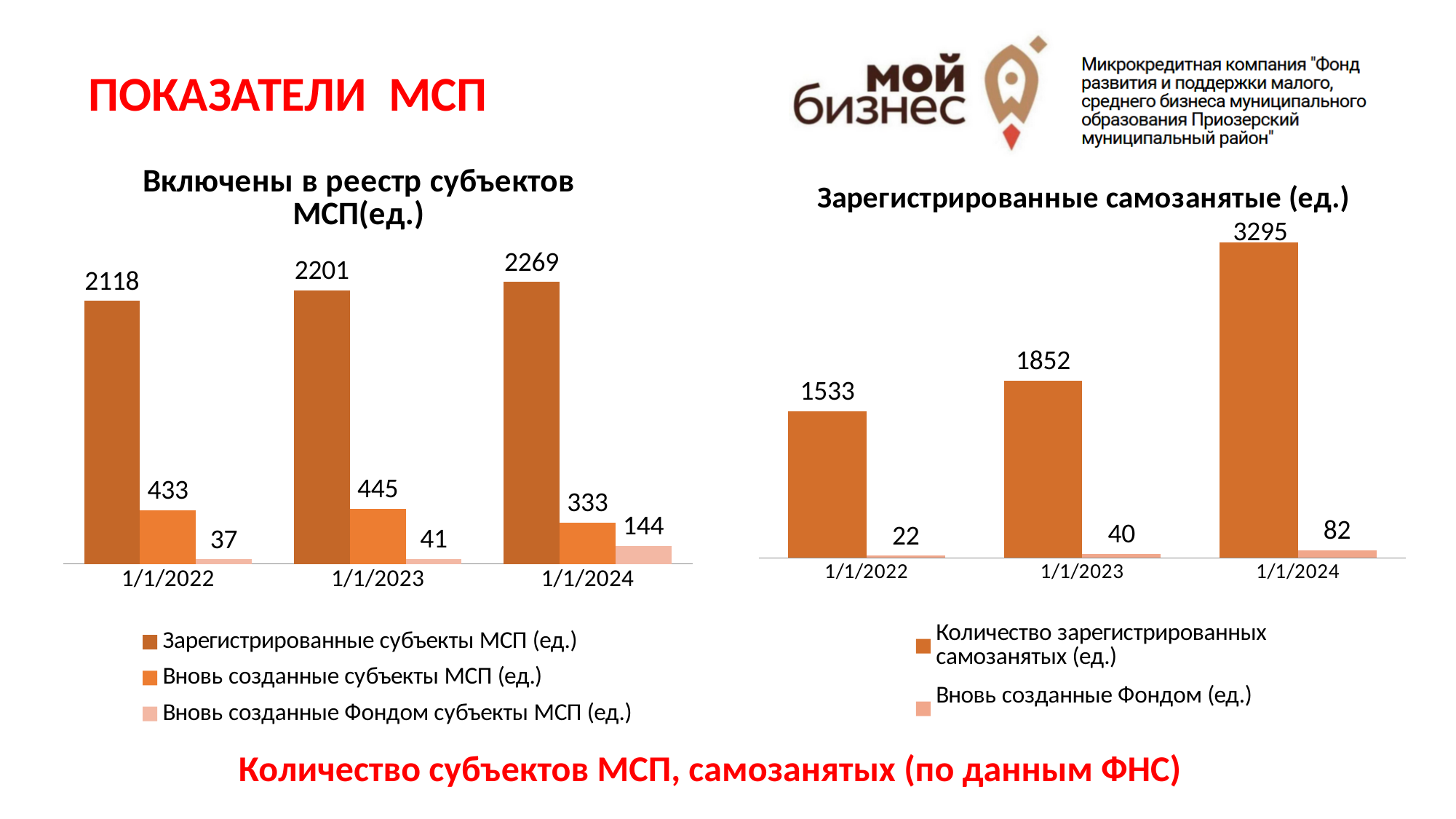
In the chart 'Зарегистрированные самозанятые (ед.)', what is the difference between the 'Количество зарегистрированных самозанятых (ед.)' values for 1/1/2024 and 1/1/2023? 1443 What type of chart is 'Зарегистрированные самозанятые (ед.)'? bar chart In the chart 'Включены в реестр субъектов МСП(ед.)', what is the value of 'Зарегистрированные субъекты МСП (ед.)' for 1/1/2023? 2201 In the chart 'Включены в реестр субъектов МСП(ед.)', does the 'Зарегистрированные субъекты МСП (ед.)' series rise or fall from 1/1/2022 to 1/1/2024? rise In the chart 'Включены в реестр субъектов МСП(ед.)', which date has the highest value for 'Вновь созданные субъекты МСП (ед.)'? 1/1/2023 In the chart 'Зарегистрированные самозанятые (ед.)', what is the value of 'Вновь созданные Фондом (ед.)' for 1/1/2023? 40 In the chart 'Включены в реестр субъектов МСП(ед.)', how many series does the legend list? 3 In the chart 'Зарегистрированные самозанятые (ед.)', how many dates are shown on the x axis? 3 In the chart 'Включены в реестр субъектов МСП(ед.)', what is the value of 'Вновь созданные Фондом субъекты МСП (ед.)' for 1/1/2024? 144 In the chart 'Зарегистрированные самозанятые (ед.)', what is the value of 'Количество зарегистрированных самозанятых (ед.)' for 1/1/2024? 3295 In the chart 'Включены в реестр субъектов МСП(ед.)', what is the difference between the 'Зарегистрированные субъекты МСП (ед.)' values for 1/1/2024 and 1/1/2022? 151 In the chart 'Зарегистрированные самозанятые (ед.)', which date has the lowest value for 'Количество зарегистрированных самозанятых (ед.)'? 1/1/2022